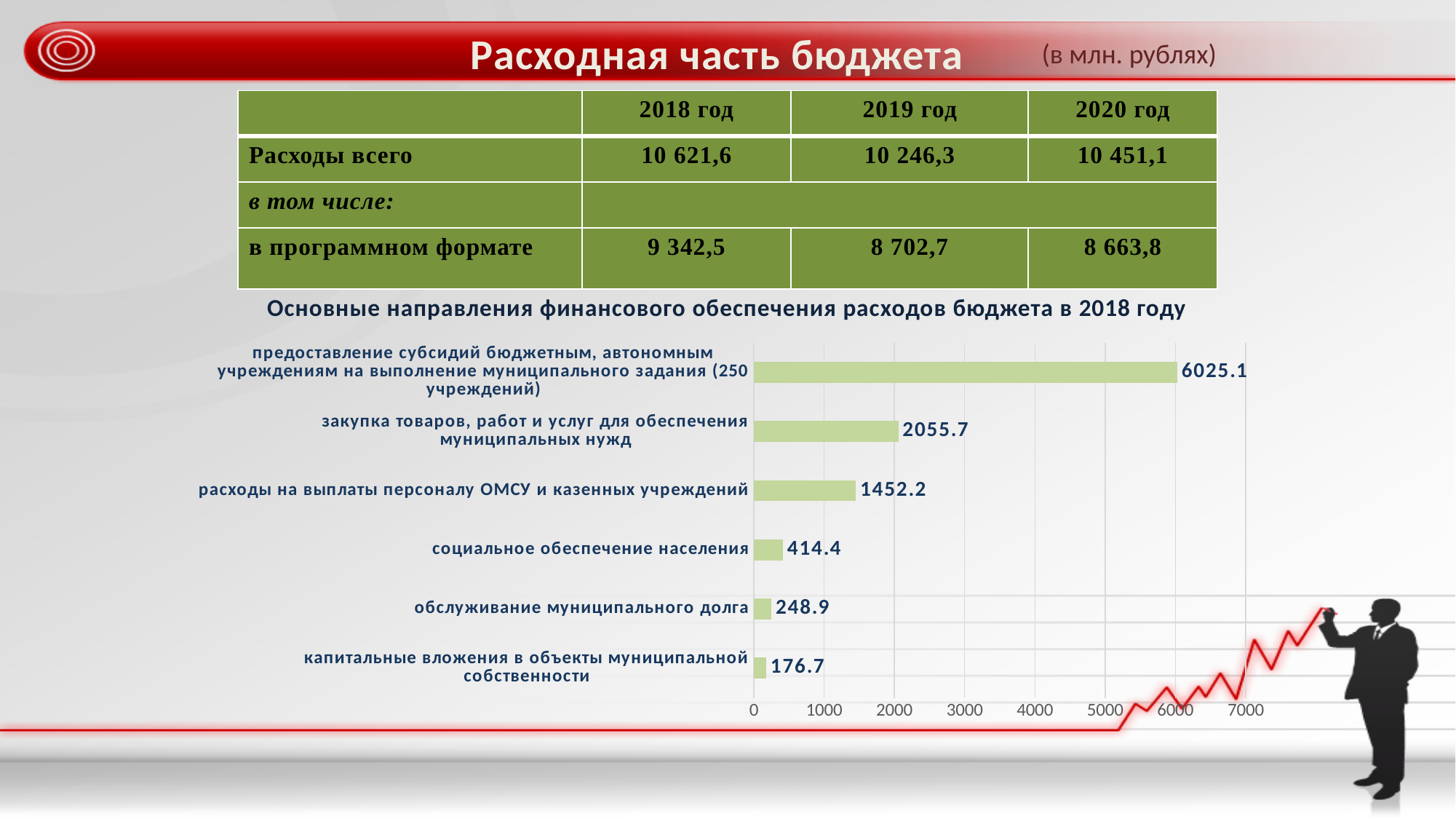
What is the value for «закупка товаров, работ и услуг для обеспечения муниципальных нужд»? 2055.7 What is the value for «обслуживание муниципального долга»? 248.9 Which is larger: the value for «социальное обеспечение населения» or the value for «обслуживание муниципального долга»? социальное обеспечение населения What is the value for «расходы на выплаты персоналу ОМСУ и казенных учреждений»? 1452.2 Which category has the lowest value in the bar chart? капитальные вложения в объекты муниципальной собственности What type of chart is shown on the slide? bar chart What is the difference between the values for «закупка товаров, работ и услуг для обеспечения муниципальных нужд» and «расходы на выплаты персоналу ОМСУ и казенных учреждений»? 603.5 Is the value for «предоставление субсидий бюджетным, автономным учреждениям на выполнение муниципального задания (250 учреждений)» greater or less than 5000? greater How many categories does the bar chart show? 6 What is the value for «социальное обеспечение населения»? 414.4 What is the title of the bar chart? Основные направления финансового обеспечения расходов бюджета в 2018 году Which category has the highest value in the bar chart? предоставление субсидий бюджетным, автономным учреждениям на выполнение муниципального задания (250 учреждений)